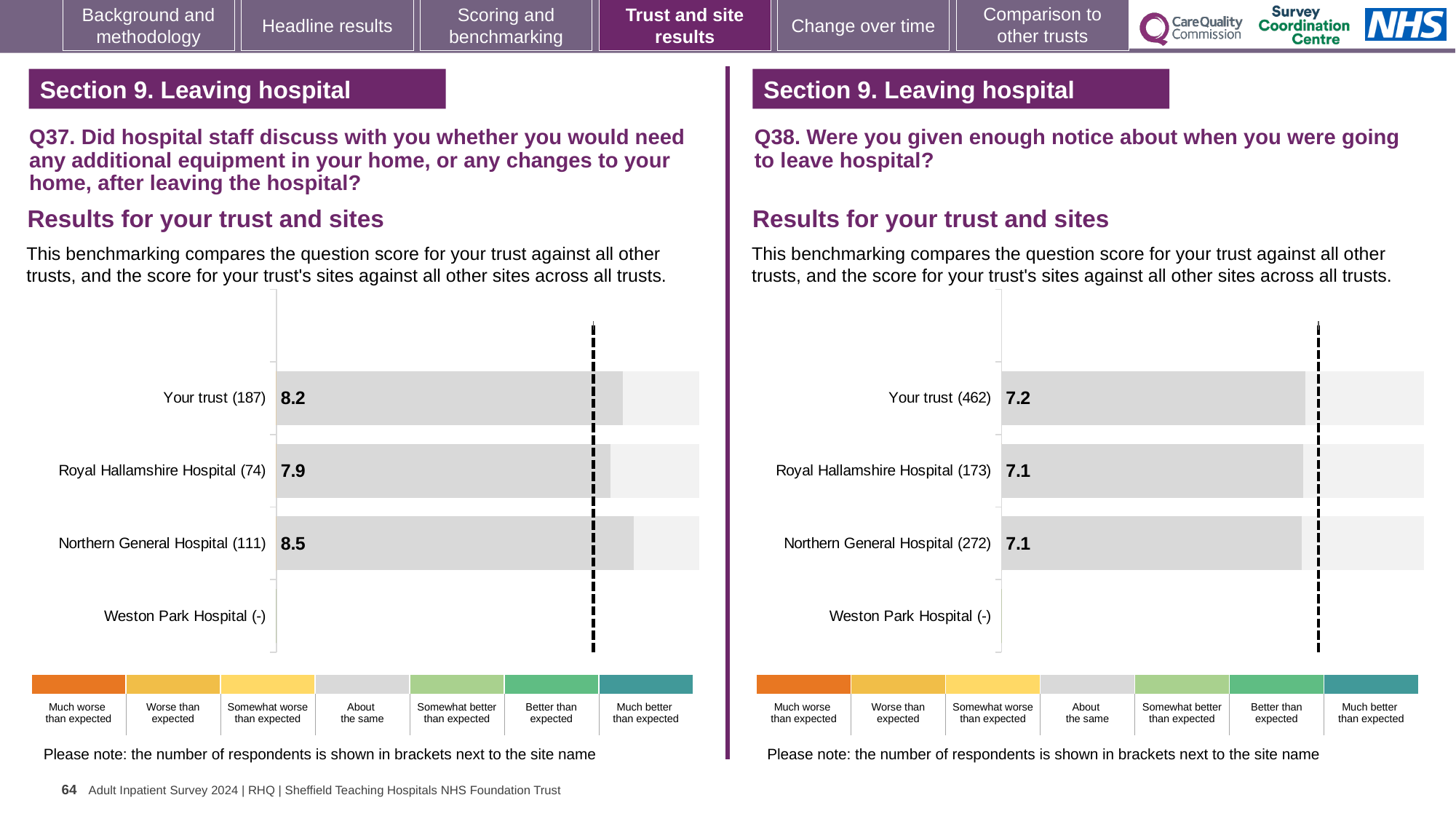
In the Q38 chart on the right, what is the difference between the scores for Your trust and Royal Hallamshire Hospital? 0.1 In the Q37 chart on the left, what is the score for Royal Hallamshire Hospital? 7.9 What type of chart is used in the Q37 chart on the left? Bar chart In the Q37 chart on the left, what is the difference between the scores for Northern General Hospital and Royal Hallamshire Hospital? 0.6 In the Q38 chart on the right, what is the score for Northern General Hospital? 7.1 How many respondents are shown in brackets for Your trust in the Q38 chart on the right? 462 In the Q38 chart on the right, how many respondents are shown in brackets for Northern General Hospital? 272 In the Q38 chart on the right, what is the score for Your trust? 7.2 In the Q37 chart on the left, which site has the highest score? Northern General Hospital In the Q37 chart on the left, what is the score for Your trust? 8.2 In the Q37 chart on the left, which is larger, the score for Your trust or the score for Royal Hallamshire Hospital? Your trust In the Q37 chart on the left, what is the score for Northern General Hospital? 8.5